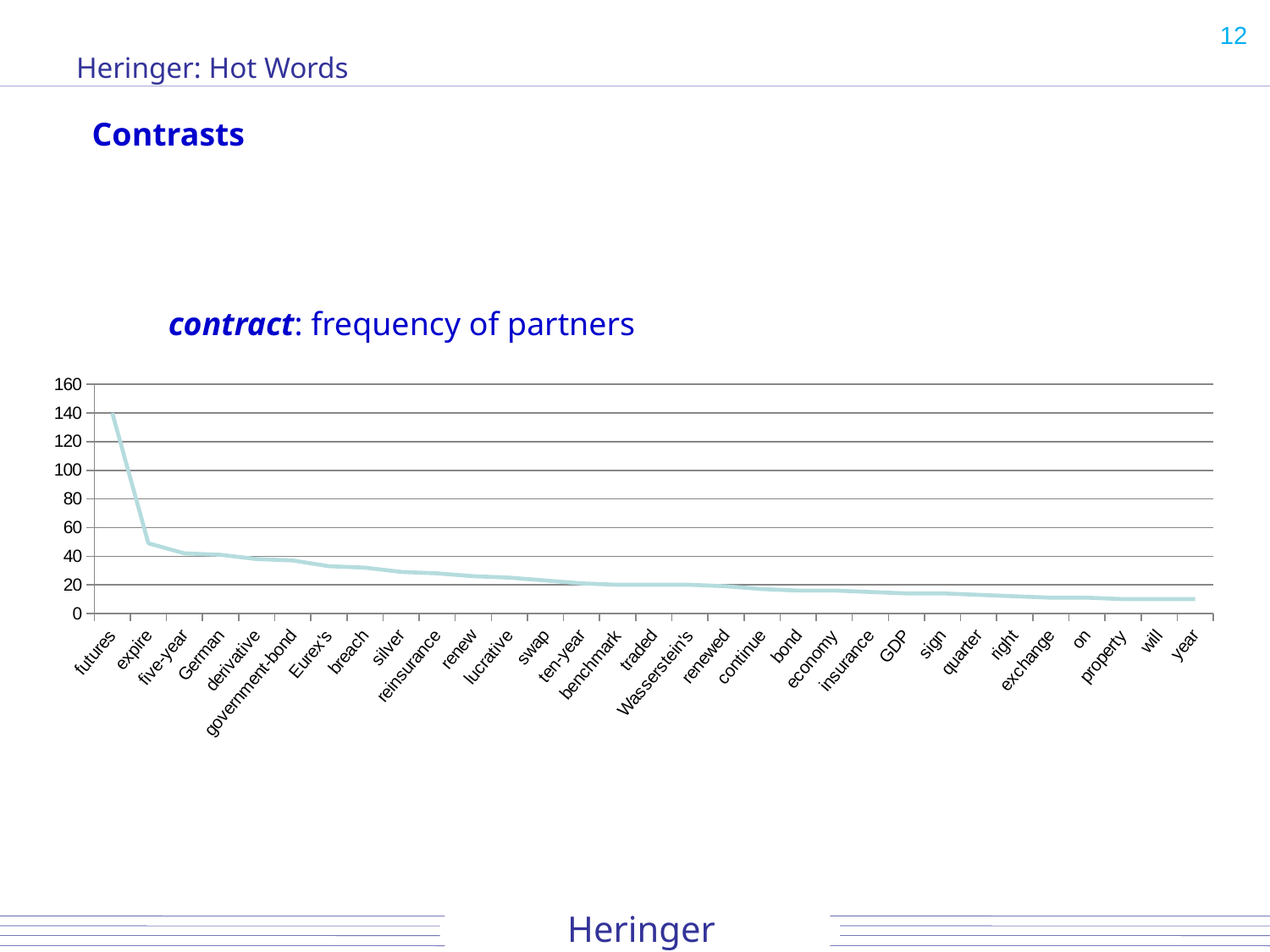
Is the value for futures greater or less than 100? greater Is the value for year greater or less than 20? less Is the value for expire greater or less than 60? less Do the values rise or fall moving from left to right along the x axis? fall Which has a higher value, German or year? German What kind of chart is shown on the slide? line chart What is the first category on the x axis? futures Which category has the highest frequency in the chart? futures Which has a higher value, futures or expire? futures What is the title of the chart? contract: frequency of partners